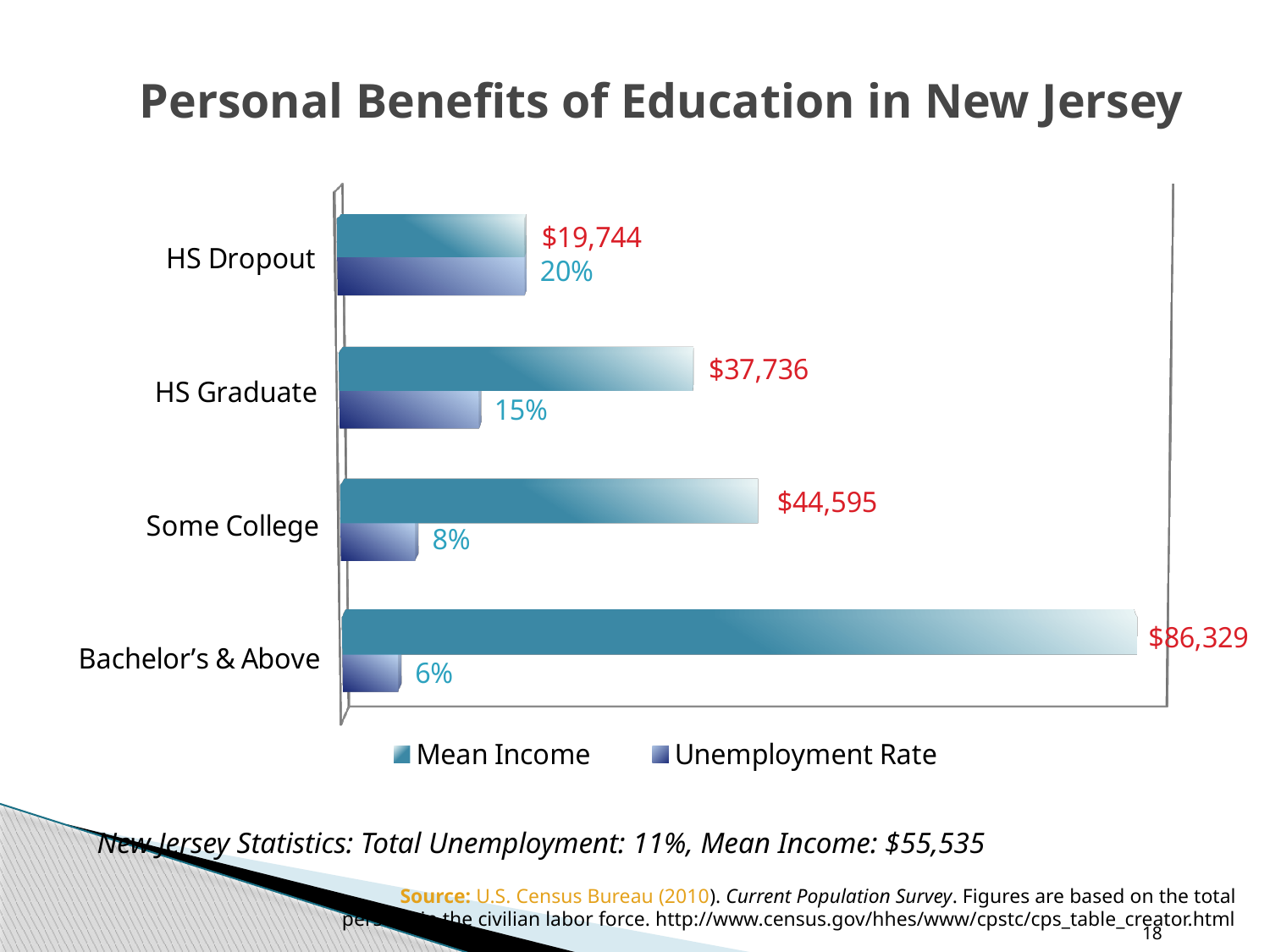
Which education level has the highest Unemployment Rate? HS Dropout What is the Mean Income for HS Dropout? $19,744 How many series does the legend list? 2 Which education level has the lowest Unemployment Rate? Bachelor's & Above Which has a higher Mean Income, HS Graduate or Some College? Some College What is the Mean Income for Some College? $44,595 Which education level has the highest Mean Income? Bachelor's & Above What is the Unemployment Rate for Bachelor's & Above? 6% What is the difference in Unemployment Rate between HS Dropout and Some College? 12% How many education levels are shown on the chart? 4 What is the difference in Mean Income between Bachelor's & Above and HS Dropout? $66,585 What is the Unemployment Rate for HS Graduate? 15%